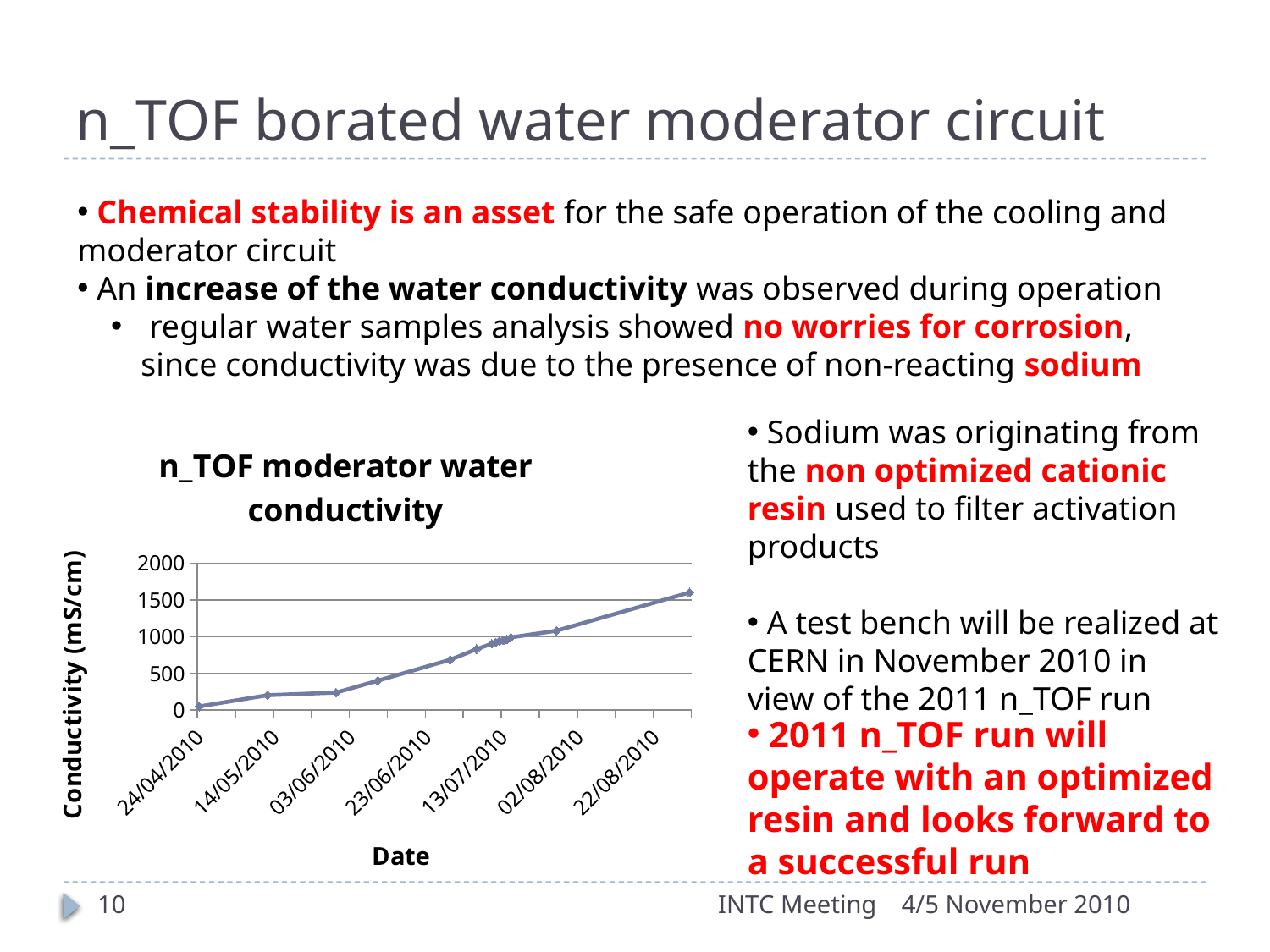
Is the conductivity value at 13/07/2010 greater or less than 1500? less Is the conductivity value at 14/05/2010 greater or less than 500? less What is the title of the chart? n_TOF moderator water conductivity Is the conductivity value at 24/04/2010 greater or less than 500? less What kind of chart is shown on the slide? line chart What is the label of the vertical axis of the chart? Conductivity (mS/cm) Which date has the highest conductivity, 24/04/2010 or 22/08/2010? 22/08/2010 How many date tick labels are shown on the x axis? 7 What is the highest value shown on the vertical axis? 2000 Does the conductivity rise or fall over time along the x axis? rise